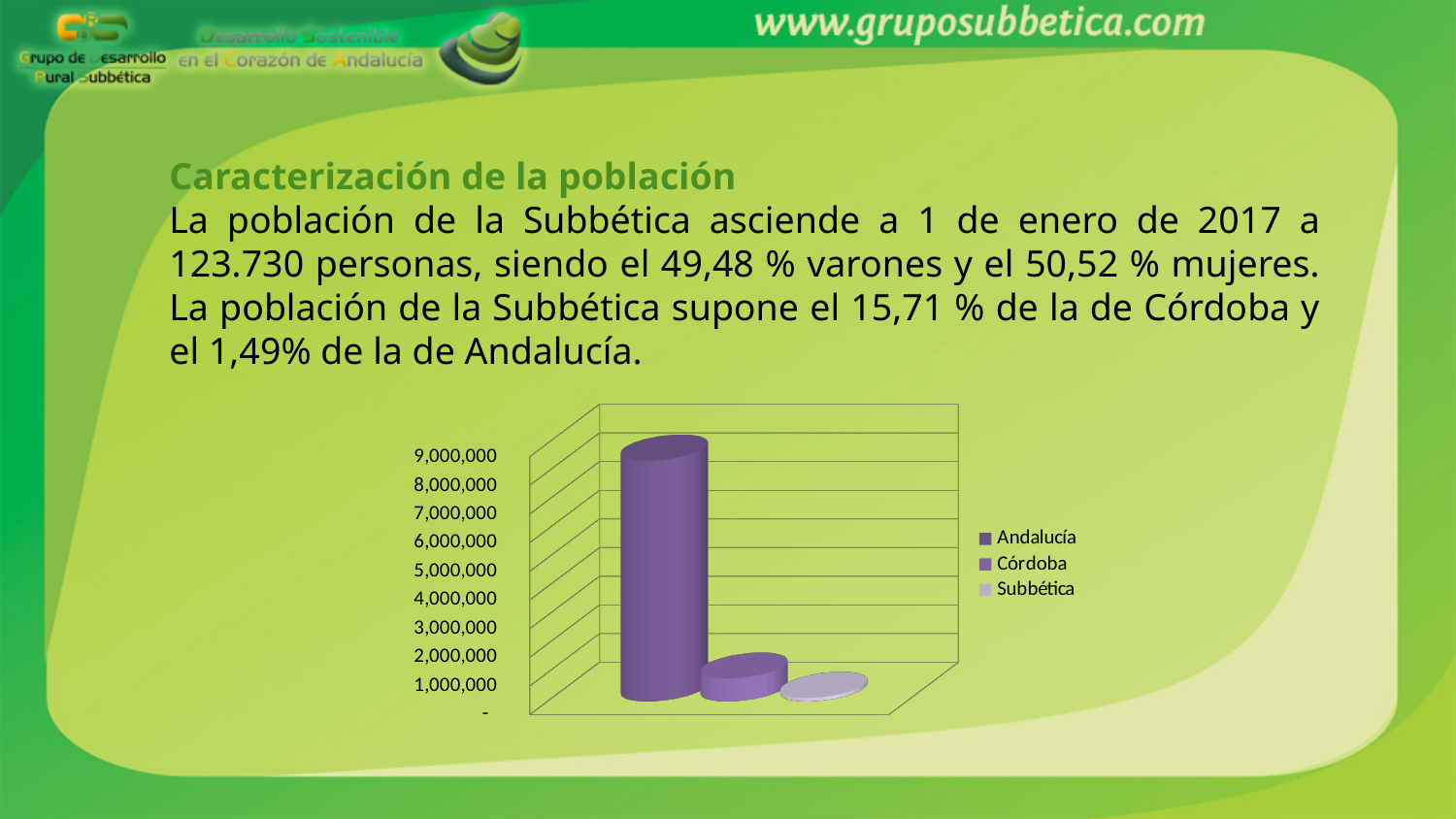
Which series has the lowest value in the chart? Subbética Is the value for Córdoba greater or less than 2,000,000? less How many series does the chart legend list? 3 Which is larger in the chart, the value for Córdoba or the value for Subbética? Córdoba What are the three entries listed in the chart legend? Andalucía, Córdoba, Subbética What kind of chart is shown on the slide? bar chart Is the value for Andalucía greater or less than 7,000,000? greater Is the value for Subbética greater or less than 1,000,000? less Which series has the highest value in the chart? Andalucía What is the highest tick value shown on the vertical axis of the chart? 9,000,000 Which is larger in the chart, the value for Andalucía or the value for Córdoba? Andalucía